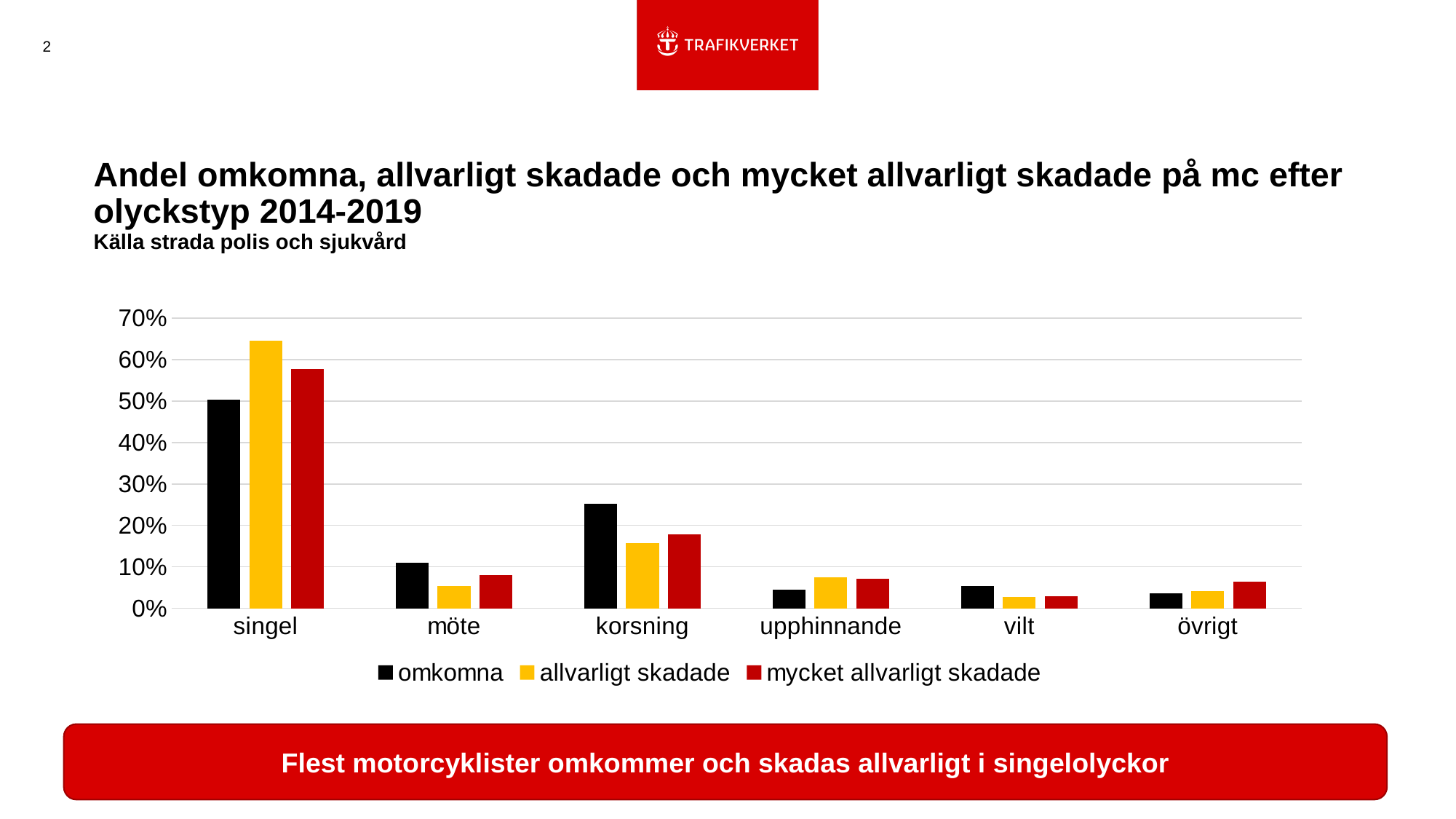
Is the value for allvarligt skadade in the möte category greater or less than 10%? less What colour represents the omkomna series in the legend? black In the singel category, which is larger: omkomna or allvarligt skadade? allvarligt skadade In the korsning category, which is larger: omkomna or allvarligt skadade? omkomna Is the value for omkomna in the korsning category greater or less than 20%? greater What kind of chart is shown on the slide? bar chart Is the value for omkomna in the singel category greater or less than 40%? greater Which category has the lowest value for mycket allvarligt skadade? vilt How many series does the legend list? 3 How many accident-type categories are shown on the x axis? 6 Which category has the highest value for allvarligt skadade? singel